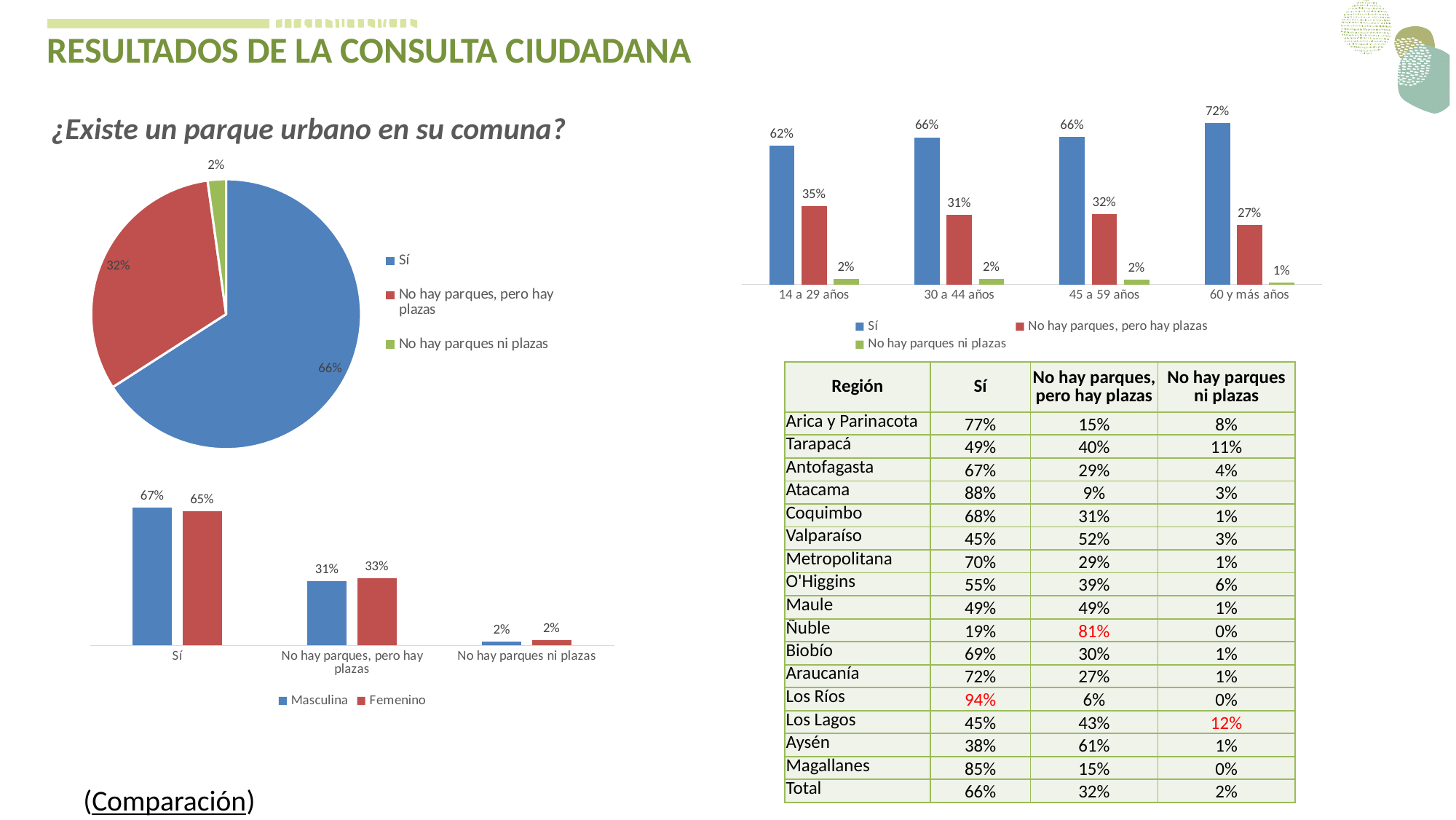
In the pie chart on the top left, what share of responses is 'Sí'? 66% In the bar chart on the bottom left, what is the value for 'No hay parques, pero hay plazas' in the Femenino series? 33% In the bar chart on the top right, what is the 'No hay parques, pero hay plazas' value for the '14 a 29 años' group? 35% How many slices does the pie chart on the top left have? 3 How many series does the legend of the bar chart on the bottom left list? 2 In the bar chart on the bottom left, what is the value for 'Sí' in the Masculina series? 67% What kind of chart is shown on the top right of the slide? Bar chart In the bar chart on the bottom left, what is the difference between the Masculina and Femenino values for 'Sí'? 2% In the bar chart on the top right, which age group has the highest 'Sí' value? 60 y más años In the pie chart on the top left, which category has the largest slice? Sí In the bar chart on the top right, what is the 'Sí' value for the '60 y más años' group? 72% In the pie chart on the top left, what share of responses is 'No hay parques ni plazas'? 2%